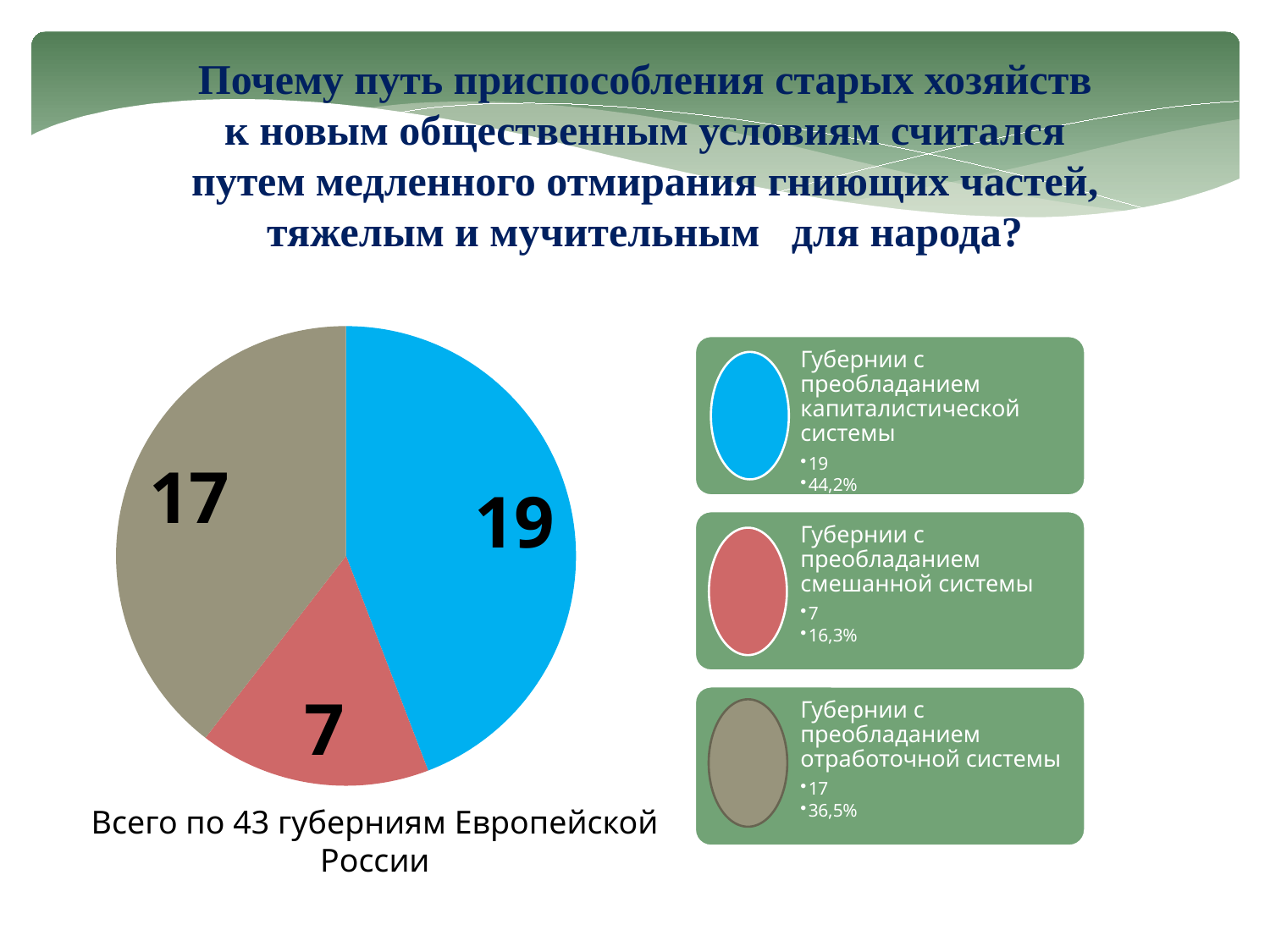
What type of chart is shown on the slide? pie chart Which category has the largest slice in the pie chart? Губернии с преобладанием капиталистической системы What is the value of the grey-brown slice (губернии с преобладанием отработочной системы)? 17 What share of the pie do the capitalist-system provinces represent, as printed on the slide? 44,2% What share of the pie do the mixed-system provinces represent, as printed on the slide? 16,3% Which is larger: the value for the capitalist-system provinces or the otrabotochnaya-system provinces? Губернии с преобладанием капиталистической системы What is the difference between the value for the capitalist-system provinces and the mixed-system provinces? 12 According to the caption under the pie chart, how many provinces of European Russia are covered in total? 43 What is the value of the red slice (губернии с преобладанием смешанной системы)? 7 Which category has the smallest slice in the pie chart? Губернии с преобладанием смешанной системы What is the value of the blue slice (губернии с преобладанием капиталистической системы)? 19 How many slices does the pie chart have? 3